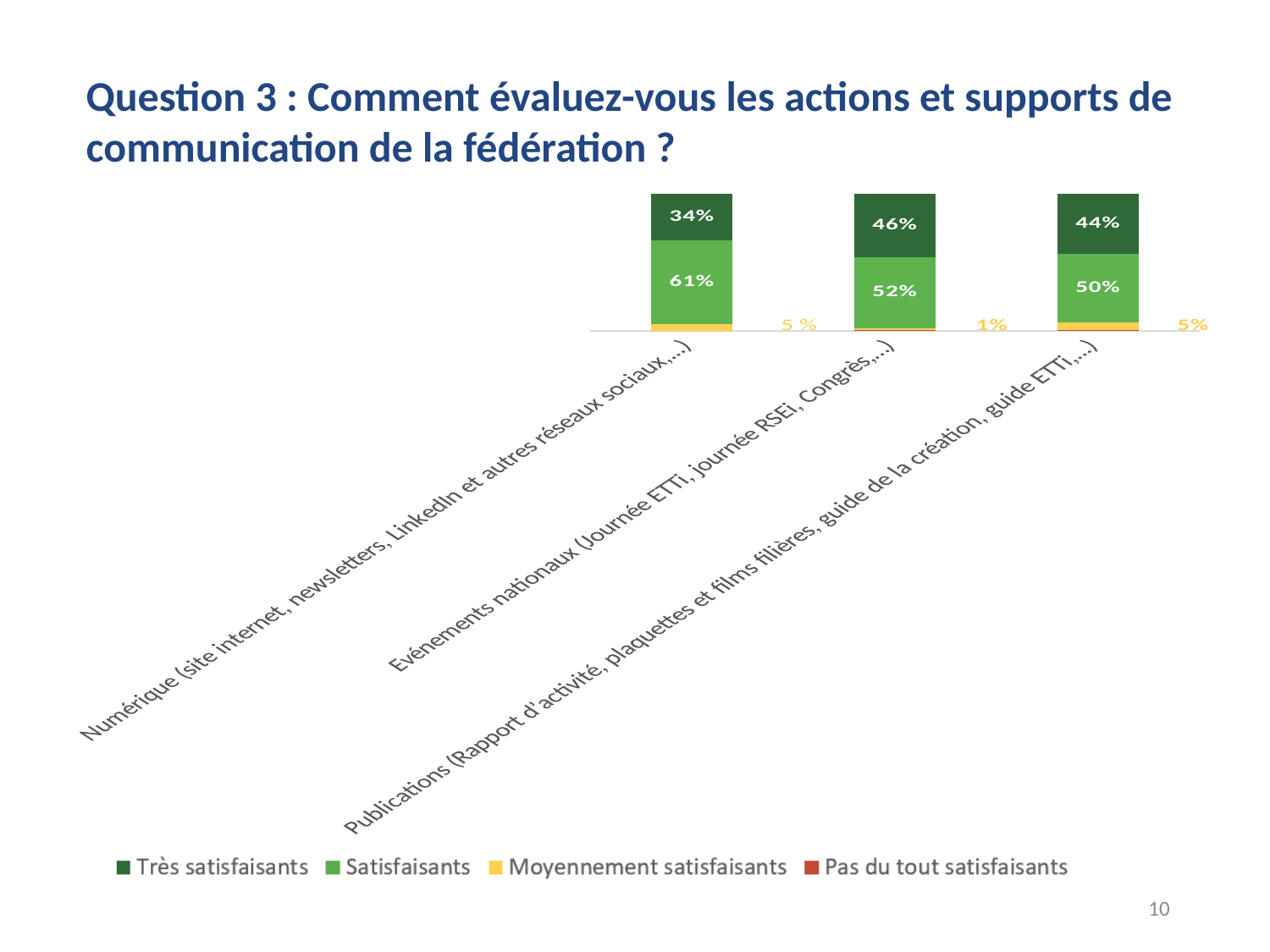
Which category has the highest Très satisfaisants share? Evénements nationaux (Journée ETTi, journée RSEi, Congrès,...) What is the Moyennement satisfaisants value for Evénements nationaux? 1% How many categories are shown on the x axis of the chart? 3 What is the difference between the Satisfaisants value for Numérique and the Satisfaisants value for Publications? 11 percentage points Which category has the highest Satisfaisants share? Numérique (site internet, newsletters, LinkedIn et autres réseaux sociaux,...) Which category has the lowest Moyennement satisfaisants share? Evénements nationaux (Journée ETTi, journée RSEi, Congrès,...) What is the Moyennement satisfaisants value for the Numérique category? 5 % What percentage of respondents rated the Numérique (site internet, newsletters, LinkedIn et autres réseaux sociaux,...) category as Très satisfaisants? 34% What is the Satisfaisants value for Evénements nationaux (Journée ETTi, journée RSEi, Congrès,...)? 52% Which has a larger Très satisfaisants value: Evénements nationaux or Publications? Evénements nationaux What is the Très satisfaisants value for Publications (Rapport d'activité, plaquettes et films filières, guide de la création, guide ETTi,...)? 44% How many series does the legend list? 4